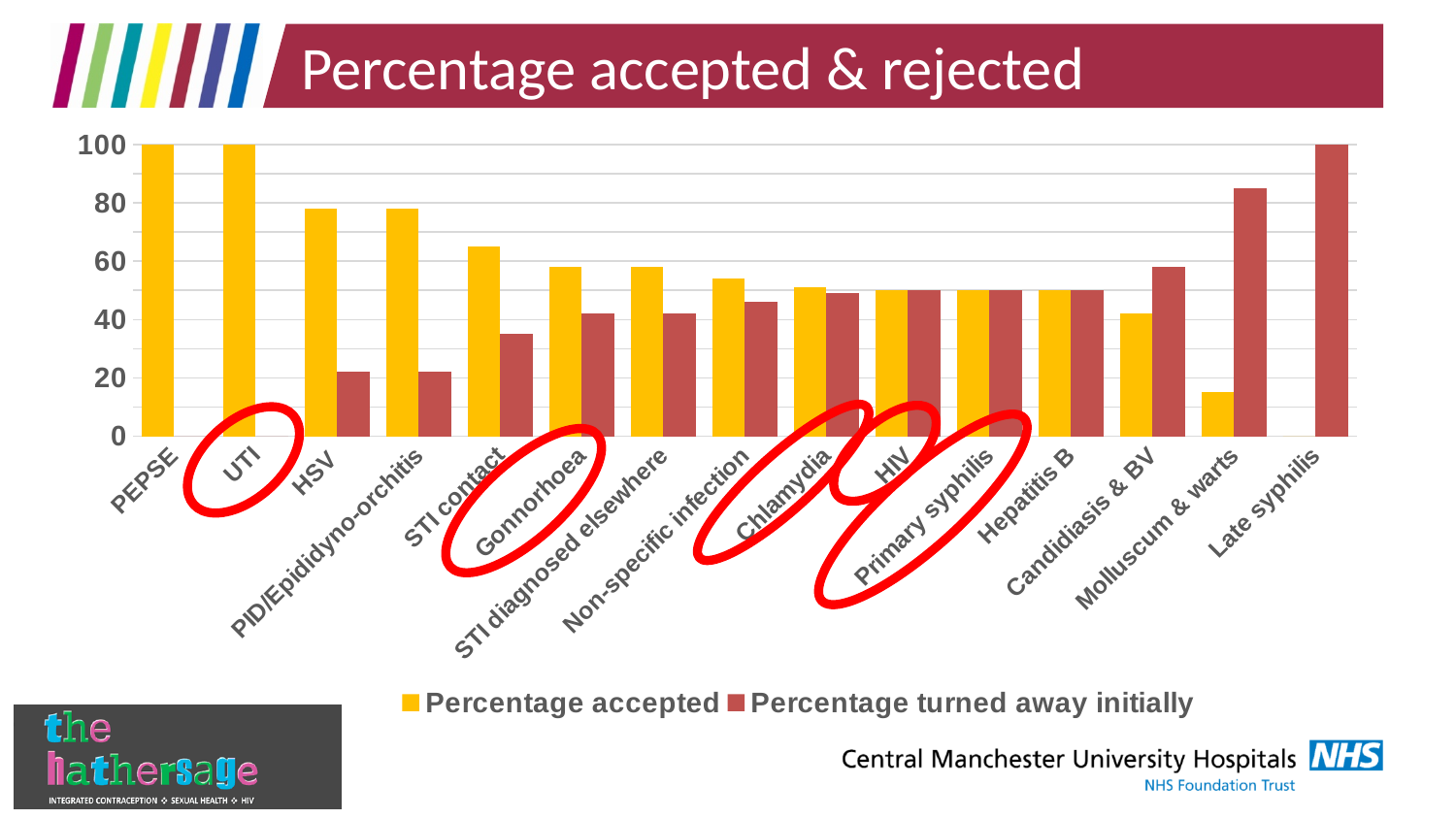
Is the percentage turned away initially for STI contact greater or less than 40? less How many categories are shown along the x axis? 15 Which category has the highest percentage turned away initially? Late syphilis How many series does the legend list? 2 What kind of chart is shown on the slide? Bar chart What is the percentage accepted for PEPSE? 100 What is the percentage turned away initially for Late syphilis? 100 Do the percentage accepted bars generally rise or fall from left to right across the categories? Fall Is the percentage accepted for HSV greater or less than 60? greater What is the percentage accepted for UTI? 100 For Candidiasis & BV, which is larger: the percentage accepted or the percentage turned away initially? Percentage turned away initially Is the percentage accepted for Molluscum & warts greater or less than 20? less